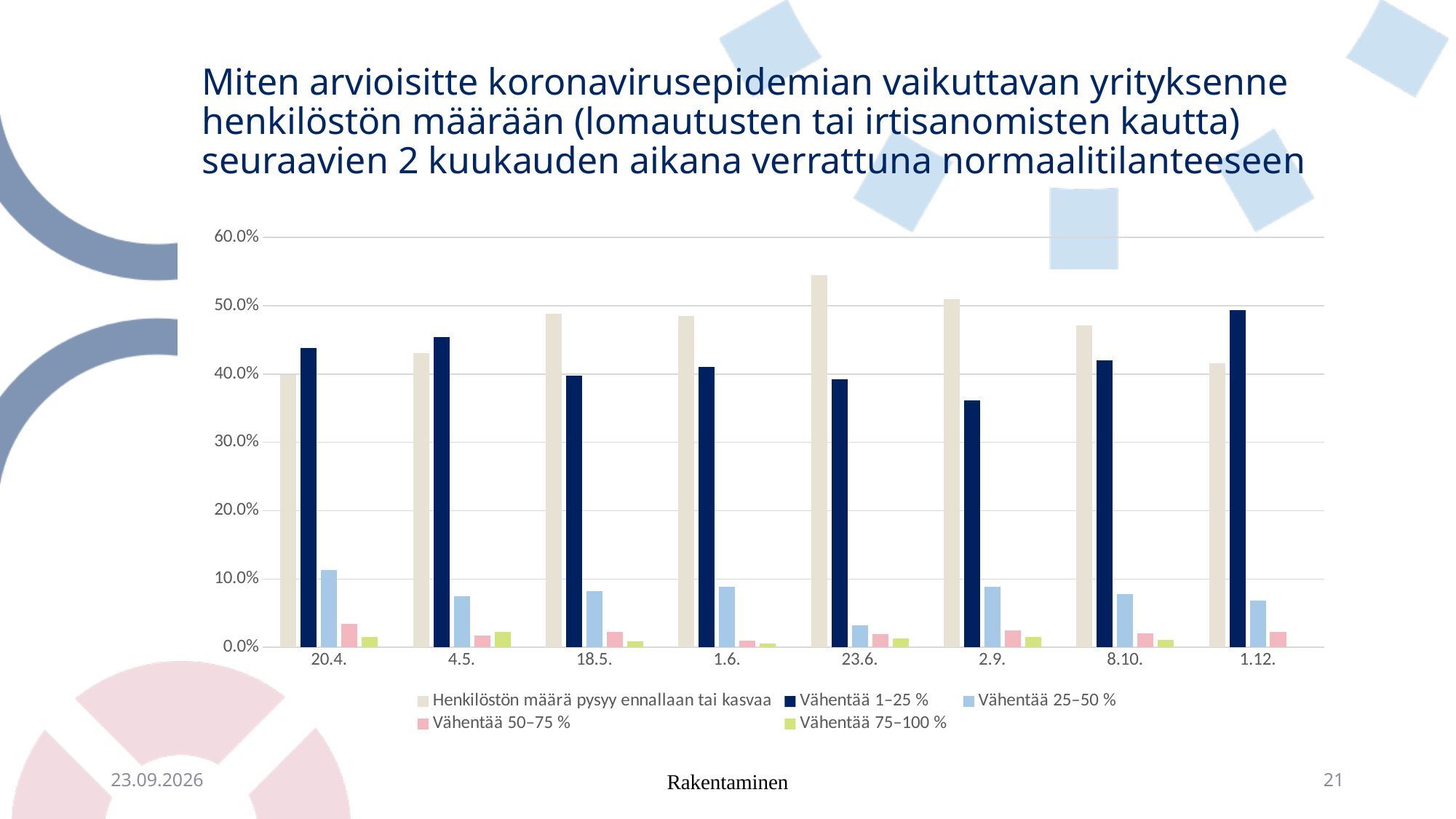
Is the value for 'Henkilöstön määrä pysyy ennallaan tai kasvaa' at 23.6. greater or less than 50.0%? greater What kind of chart is shown on the slide? bar chart For which date is the value of 'Vähentää 25–50 %' highest? 20.4. How many date categories are shown on the x axis? 8 For which date is the value of 'Henkilöstön määrä pysyy ennallaan tai kasvaa' highest? 23.6. At 20.4., which is larger: 'Vähentää 1–25 %' or 'Henkilöstön määrä pysyy ennallaan tai kasvaa'? Vähentää 1–25 % For which date is the value of 'Vähentää 1–25 %' lowest? 2.9. Which series is shown in dark navy blue in the legend? Vähentää 1–25 % How many series does the legend list? 5 For which date is the value of 'Vähentää 25–50 %' lowest? 23.6. Is the value for 'Vähentää 1–25 %' at 2.9. greater or less than 40.0%? less For which date is the value of 'Vähentää 1–25 %' highest? 1.12.